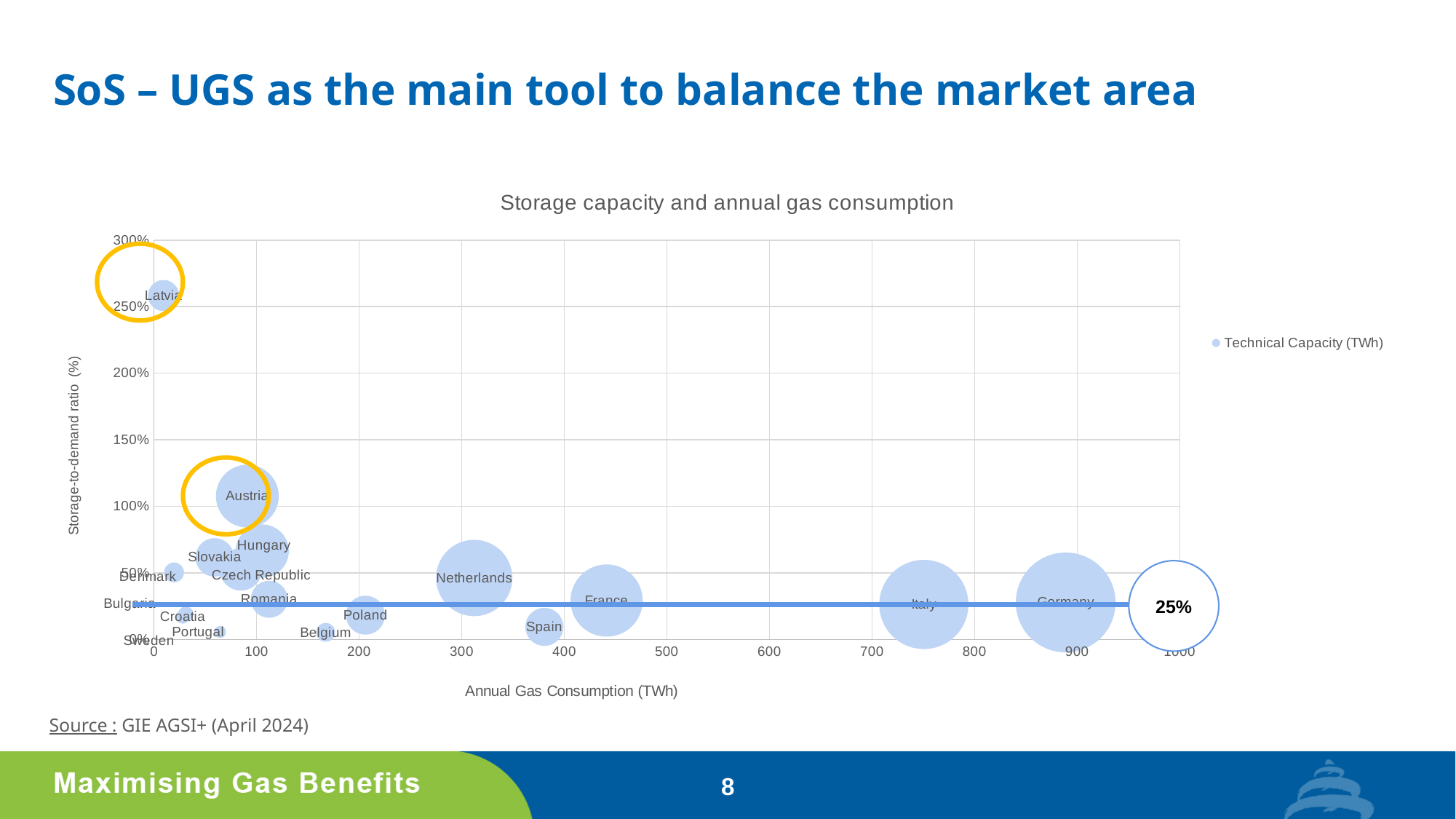
How many series does the chart legend list? 1 Which country has the highest storage-to-demand ratio? Latvia Which has the higher annual gas consumption, France or Italy? Italy What kind of chart is shown on the slide? bubble chart Which has the higher storage-to-demand ratio, Latvia or Austria? Latvia Which country has the highest annual gas consumption? Germany Is the storage-to-demand ratio for Latvia greater or less than 250%? greater Is the annual gas consumption for Netherlands greater or less than 400 TWh? less Is the storage-to-demand ratio for Austria greater or less than 150%? less What value is labelled on the horizontal reference line across the chart? 25% What is the title of the chart? Storage capacity and annual gas consumption